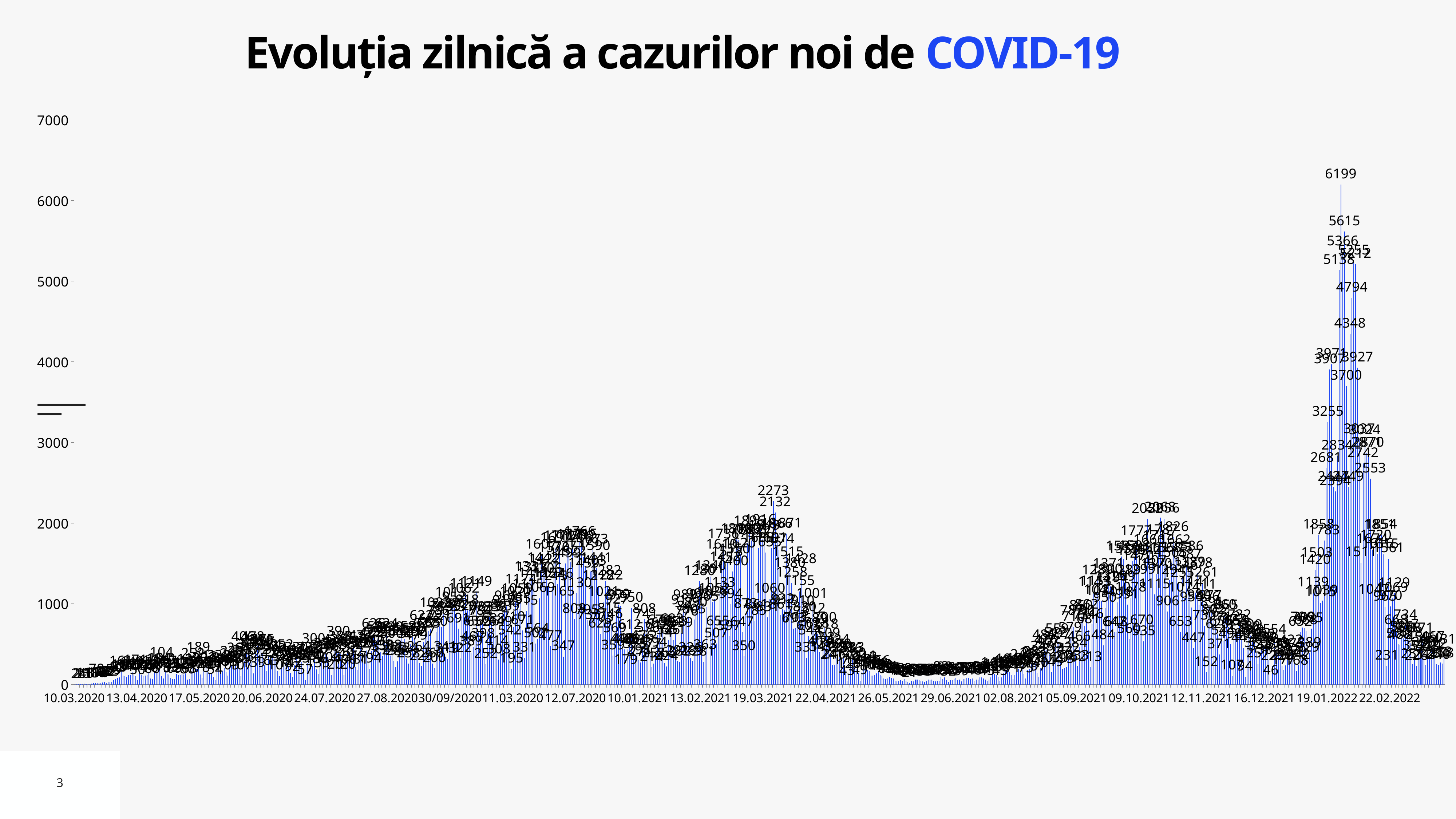
What is the second-highest value labelled on the chart, just below the 6199 peak? 5615 What kind of chart is shown on the slide? bar chart Which is larger: the overall peak of 6199 or the March 2021 peak of 2273? 6199 What is the maximum value shown on the vertical axis? 7000 What is the highest daily value labelled on the chart? 6199 Do the daily values rise or fall between 16.12.2021 and 19.01.2022? rise What is the title of the chart? Evoluția zilnică a cazurilor noi de COVID-19 Do the daily values rise or fall between 22.04.2021 and 26.05.2021? fall Is the highest value of the wave around 19.03.2021 greater or less than 3000? less What is the difference between the overall peak value 6199 and the March 2021 peak value 2273? 3926 What is the highest value labelled at the peak of the wave around 19.03.2021? 2273 Is the highest value of the wave in early 2022 greater or less than 6000? greater